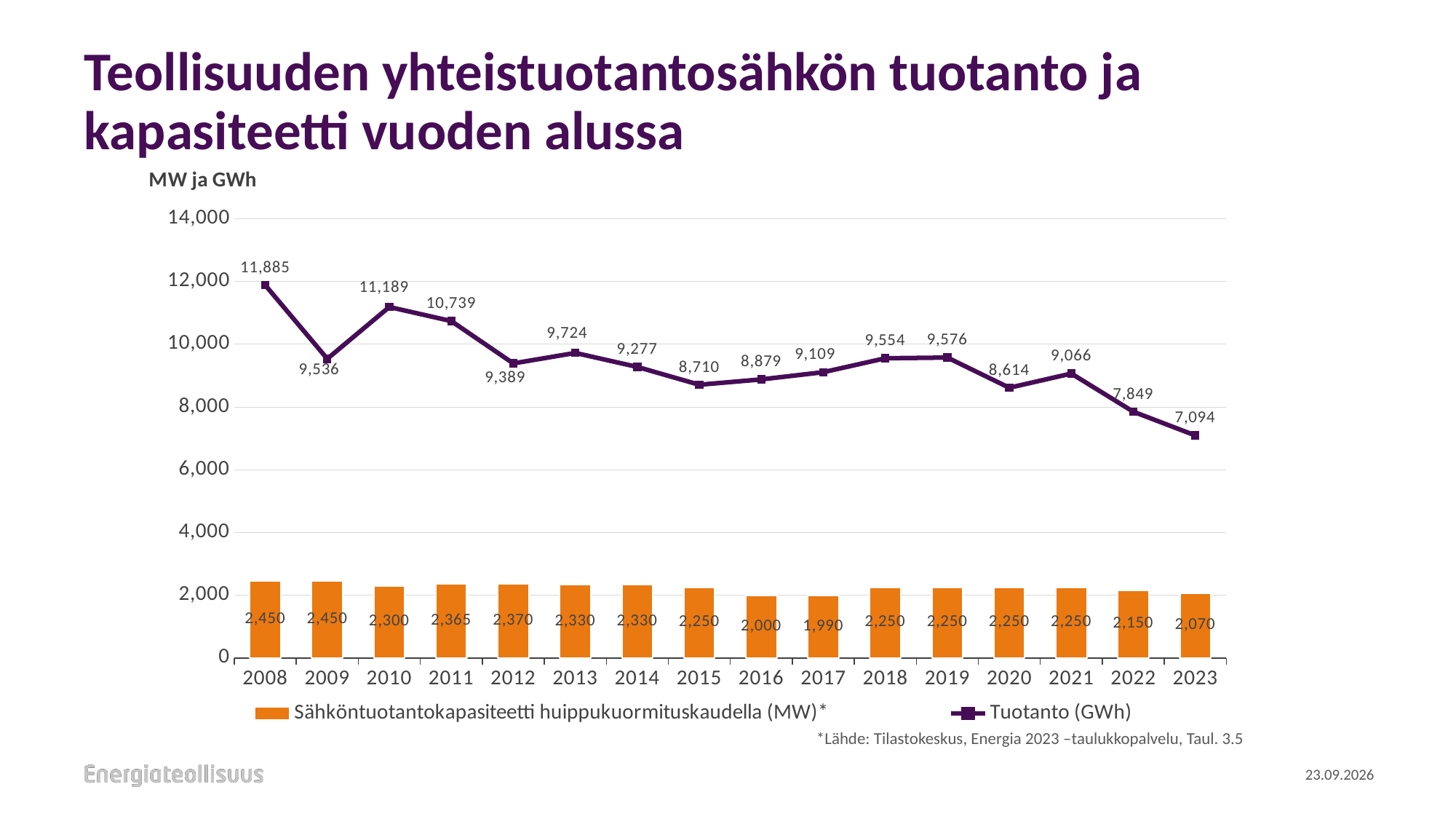
How many series does the legend list? 2 Is the Tuotanto (GWh) value for 2022 greater or less than 8,000? less What is the Tuotanto (GWh) value for 2023? 7,094 How many years are shown on the x axis? 16 In which year is the Sähköntuotantokapasiteetti (MW) lowest? 2017 What kind of chart is shown on the slide? Combined bar and line chart In which year is Tuotanto (GWh) highest? 2008 In which year is Tuotanto (GWh) lowest? 2023 Which year has the larger Tuotanto (GWh) value, 2010 or 2011? 2010 What is the Sähköntuotantokapasiteetti huippukuormituskaudella (MW) value for 2017? 1,990 What is the difference between the Tuotanto (GWh) values for 2008 and 2023? 4,791 What is the Tuotanto (GWh) value for 2008? 11,885